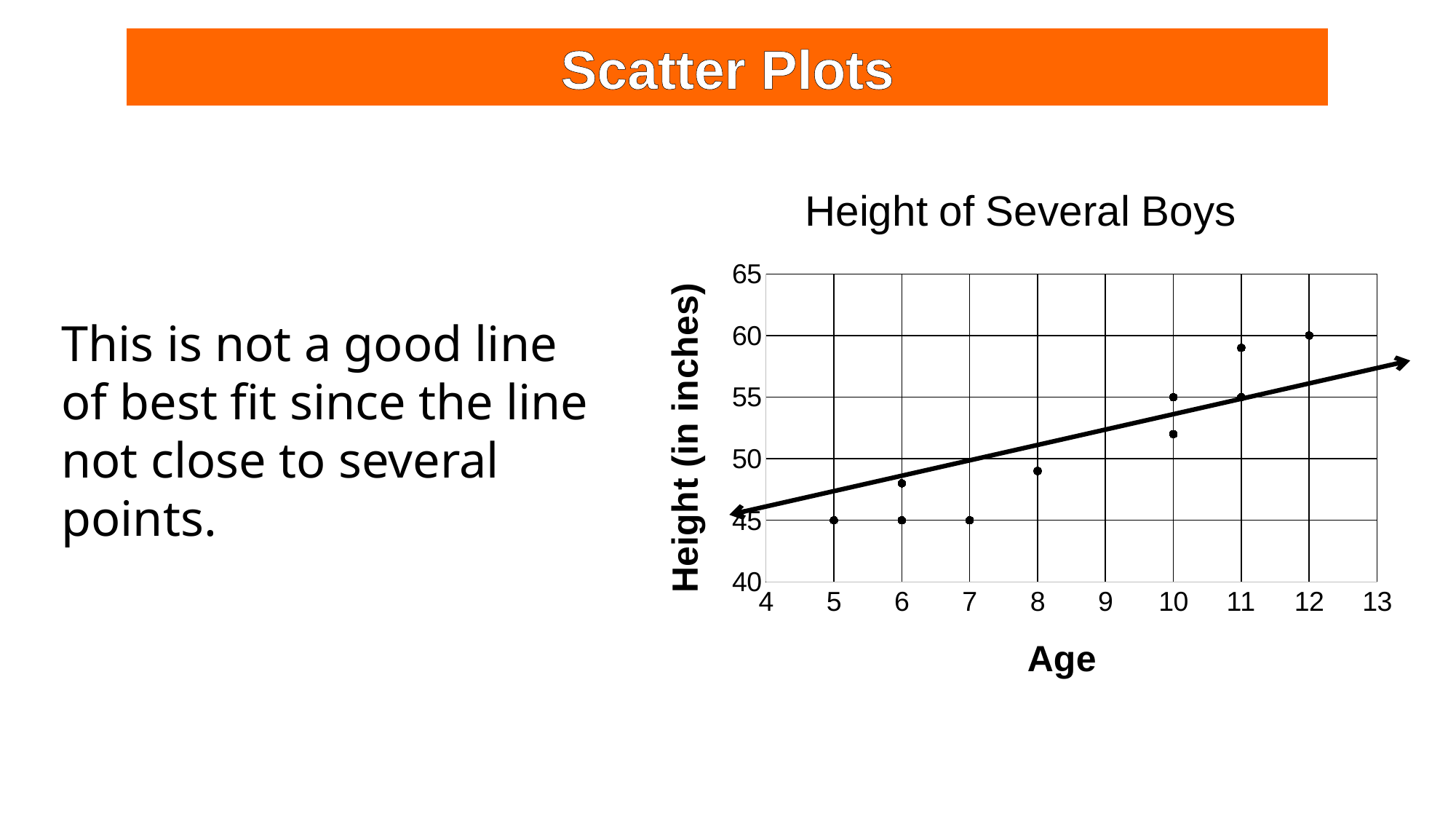
What height is plotted for age 12? 60 What height is plotted for age 7? 45 What kind of chart is shown on the slide? scatter plot Which is larger, the height plotted for age 12 or the height plotted for age 5? age 12 What height is plotted for age 5? 45 At which age is the highest height plotted? 12 What is the lowest height plotted on the chart? 45 What is the title of the chart? Height of Several Boys Do the plotted heights generally rise or fall as age increases? rise Is the height plotted for age 8 greater or less than 50? less What is the label of the vertical axis of the chart? Height (in inches) How many data points are plotted on the chart? 10